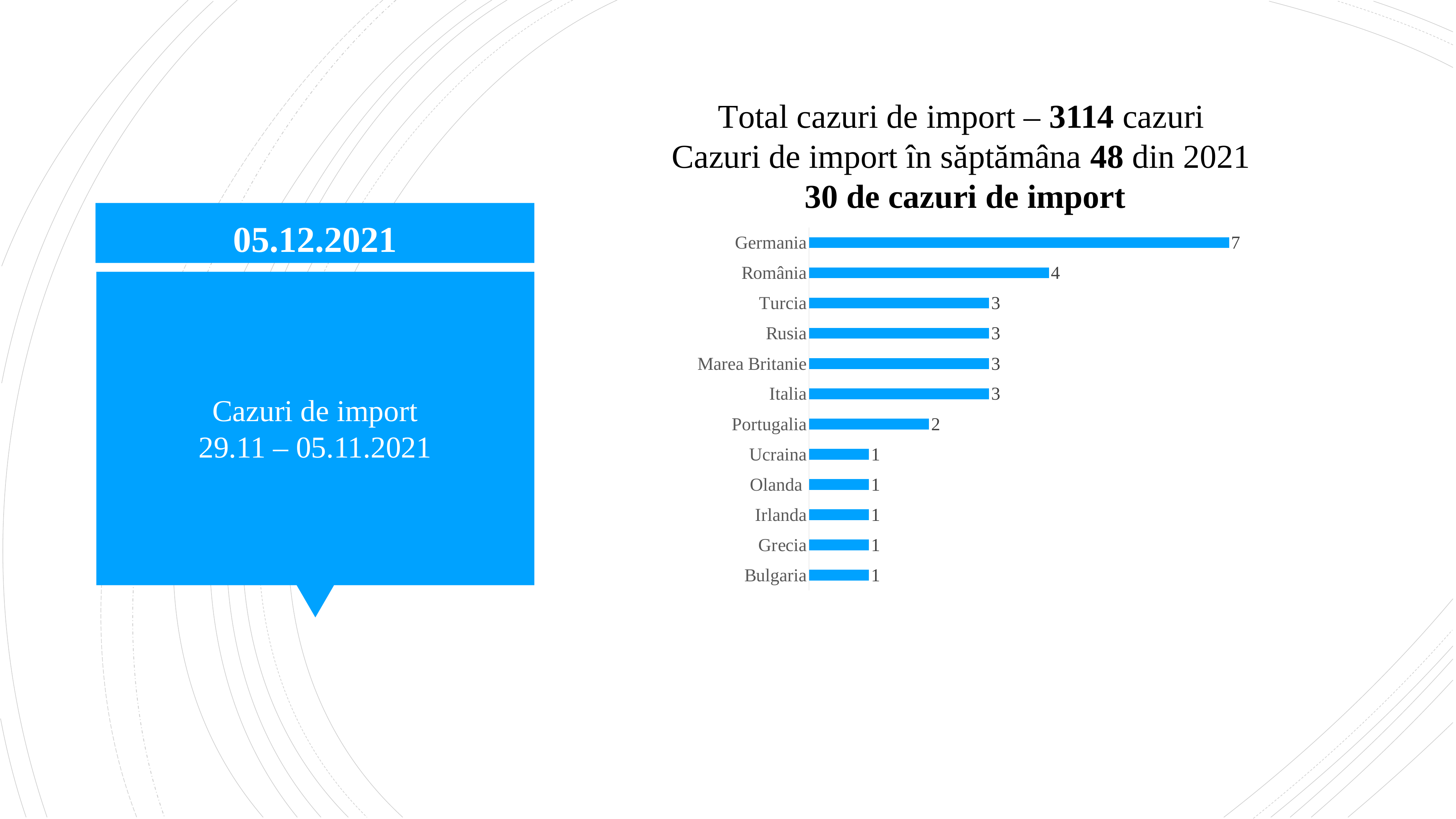
What is the difference between the values for Turcia and Ucraina? 2 What kind of chart is shown on the slide? bar chart What is the difference between the values for Germania and România? 3 How many countries are shown in the chart? 12 Which country has the highest value? Germania What is the value for Marea Britanie? 3 What is the value for Germania? 7 How many countries have a value of 1? 5 What is the value for România? 4 Which is larger, the value for România or the value for Italia? România Which is larger, the value for Portugalia or the value for Grecia? Portugalia What is the value for Portugalia? 2